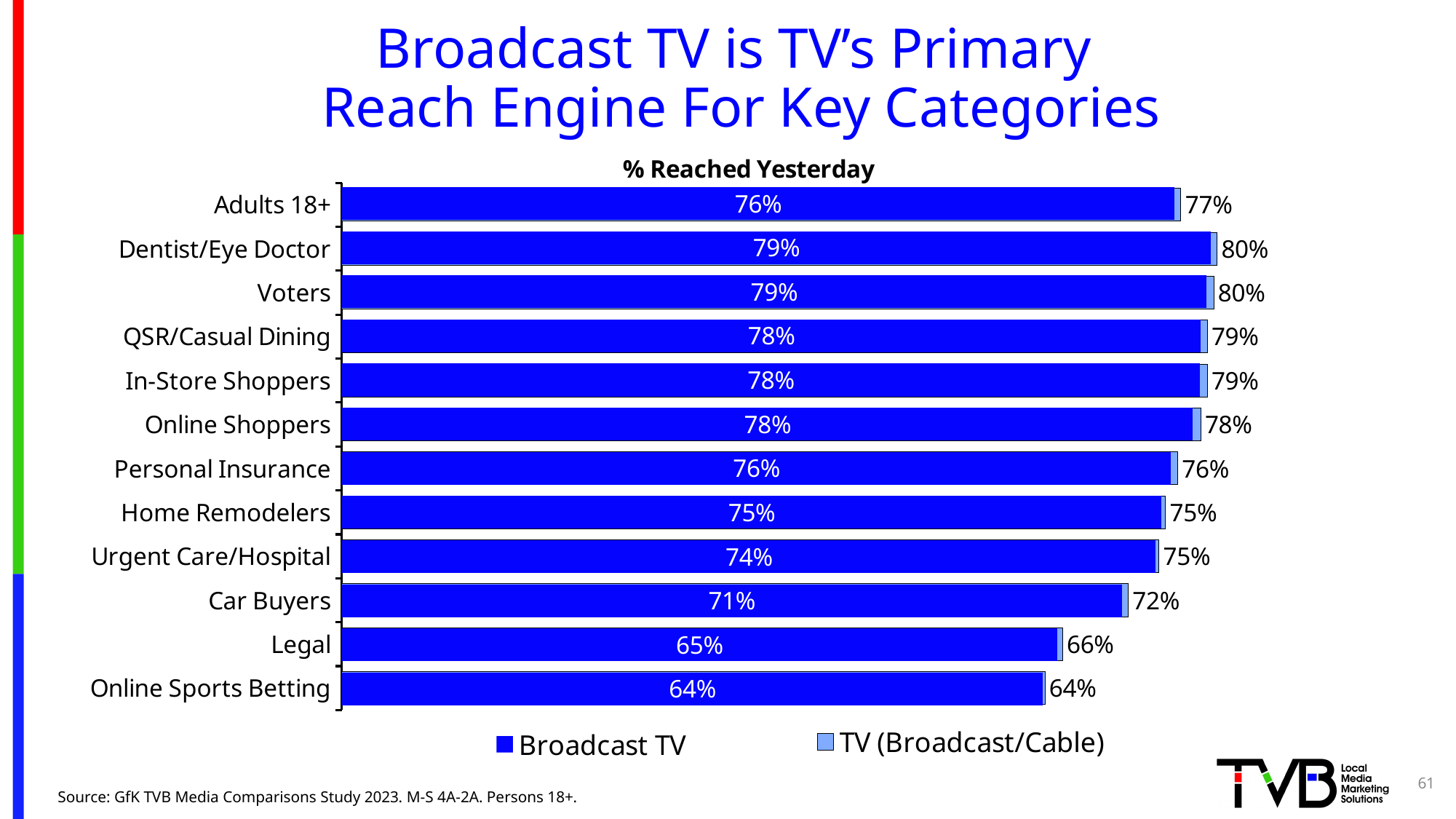
What is the TV (Broadcast/Cable) value for Adults 18+? 77% How many series does the legend list? 2 What is the difference between the TV (Broadcast/Cable) value and the Broadcast TV value for Dentist/Eye Doctor? 1% What is the Broadcast TV value for Car Buyers? 71% Which category has the lowest Broadcast TV value? Online Sports Betting Which is larger, the Broadcast TV value for Home Remodelers or for Car Buyers? Home Remodelers How many categories are shown in the chart? 12 What is the Broadcast TV value for Urgent Care/Hospital? 74% What is the TV (Broadcast/Cable) value for Legal? 66% What is the title shown above the chart? % Reached Yesterday What kind of chart is shown on the slide? Bar chart What is the difference between the Broadcast TV values for Voters and Legal? 14%